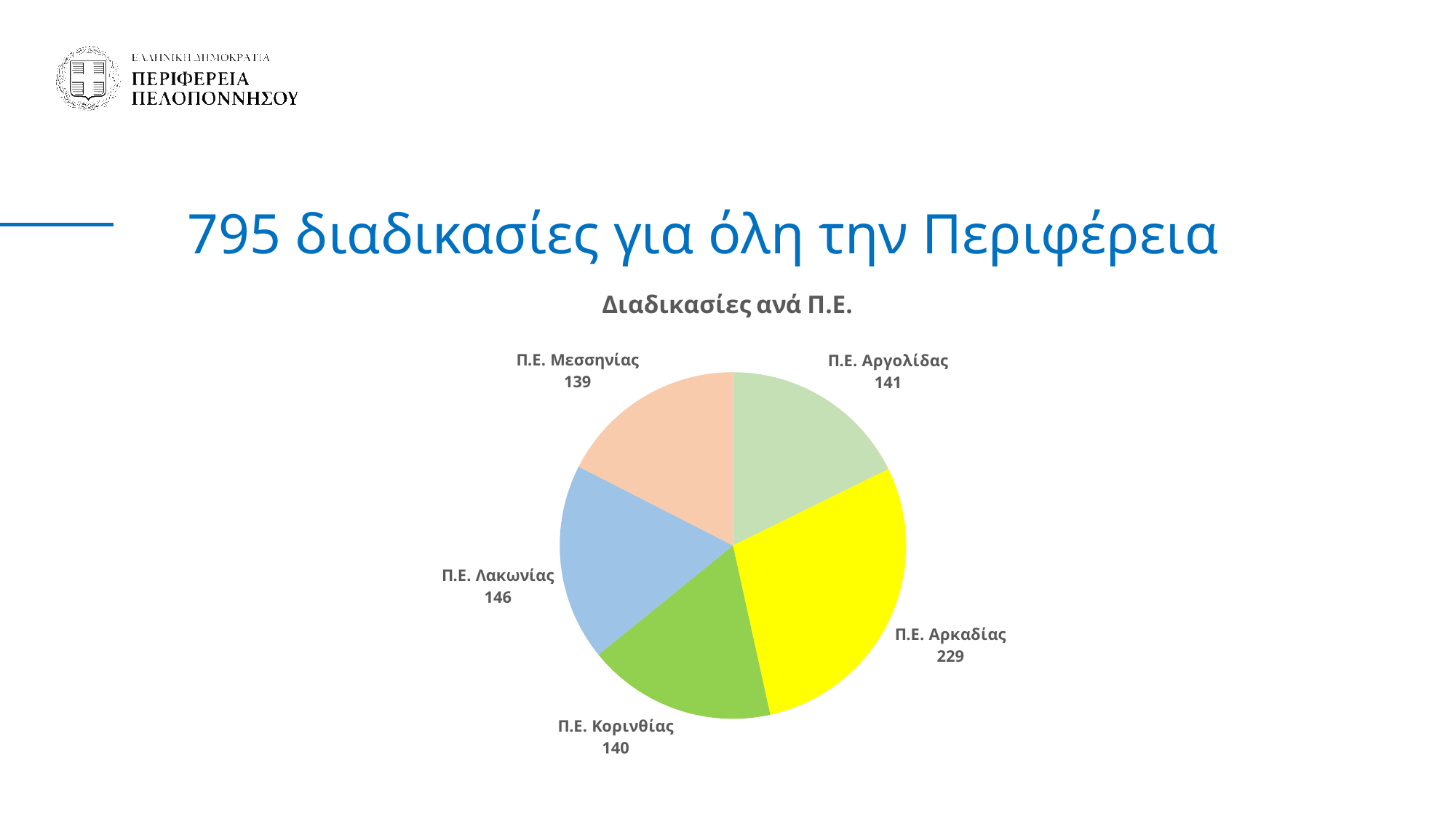
What is the difference between the values for Π.Ε. Αρκαδίας and Π.Ε. Αργολίδας? 88 What share of the total does the Π.Ε. Αρκαδίας slice represent? 28.8% Which is larger, the value for Π.Ε. Αρκαδίας or the value for Π.Ε. Κορινθίας? Π.Ε. Αρκαδίας What is the value for Π.Ε. Αρκαδίας? 229 What colour is the slice for Π.Ε. Αρκαδίας? Yellow Which Π.Ε. has the lowest value? Π.Ε. Μεσσηνίας What is the value for Π.Ε. Μεσσηνίας? 139 How many slices does the pie chart have? 5 What is the title of the chart? Διαδικασίες ανά Π.Ε. What type of chart is shown on the slide? Pie chart Which Π.Ε. has the highest value? Π.Ε. Αρκαδίας What is the value for Π.Ε. Λακωνίας? 146